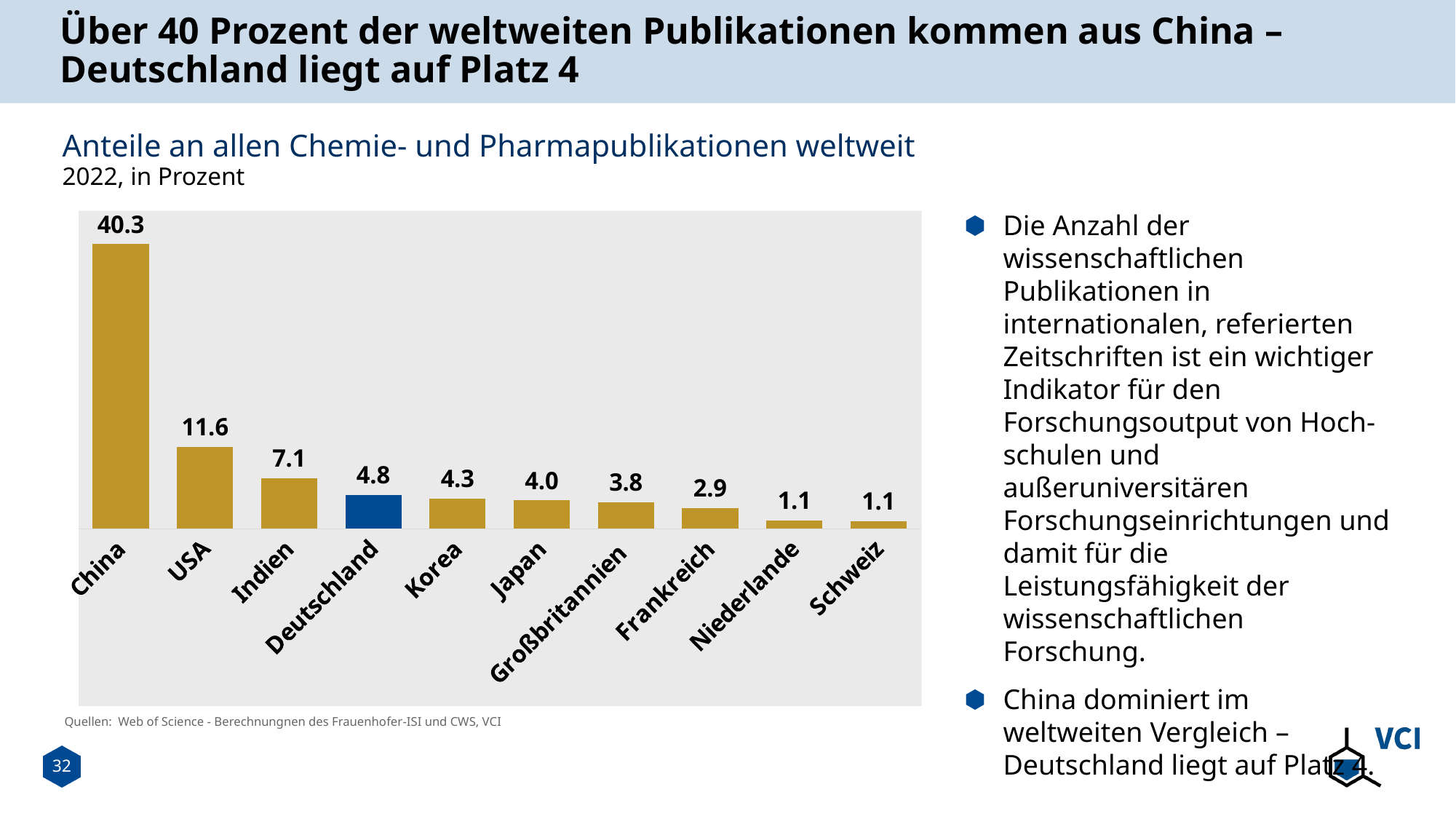
What is the value for Frankreich? 2.9 What kind of chart is shown on the slide? Bar chart Which is larger, the value for Korea or the value for Japan? Korea What is the value for China? 40.3 How many countries are shown in the chart? 10 What is the value for Deutschland? 4.8 What is the difference between the values for Indien and Deutschland? 2.3 Which country has the highest share? China What is the value for Großbritannien? 3.8 Do the values rise or fall from left to right along the x axis? Fall Which bar is coloured blue instead of gold? Deutschland What is the difference between the values for China and USA? 28.7